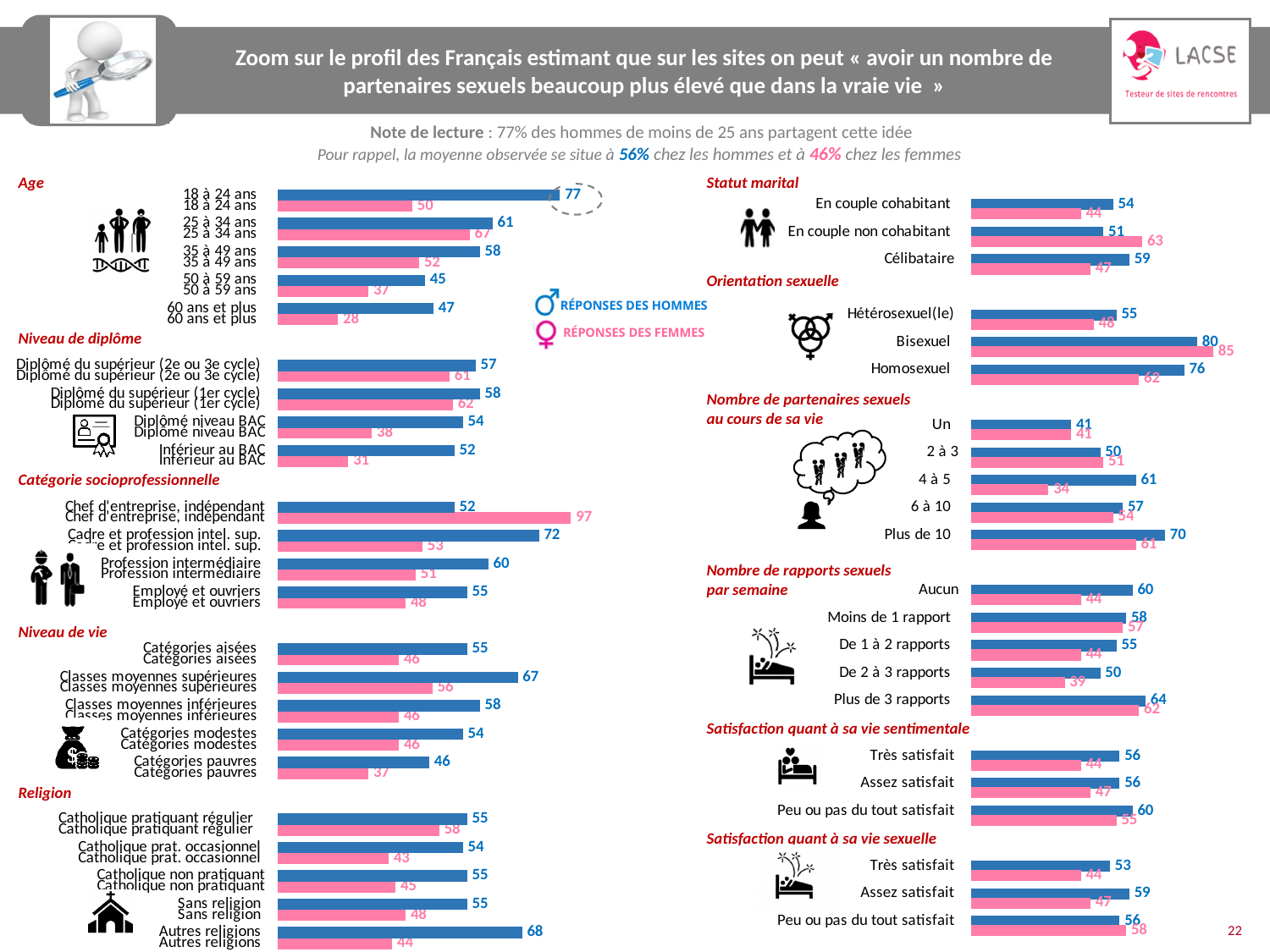
In the Age chart, what is the value for men (Réponses des hommes) aged 18 à 24 ans? 77 In the Nombre de partenaires sexuels au cours de sa vie chart, what is the men's value for Plus de 10? 70 In the Statut marital chart, which is larger for En couple non cohabitant: the men's value or the women's value? the women's value In the Niveau de diplôme chart, what is the difference between the men's and women's values for Inférieur au BAC? 21 In the Nombre de rapports sexuels par semaine chart, what is the women's value for De 2 à 3 rapports? 39 How many categories are shown in the Niveau de vie chart? 5 In the Catégorie socioprofessionnelle chart, what is the value for women (Réponses des femmes) for Chef d'entreprise, indépendant? 97 In the Orientation sexuelle chart, which category has the highest value for men? Bisexuel In the Age chart, which age group has the lowest value for women? 60 ans et plus How many series does the legend list on the slide? 2 What kind of chart is used in the Religion section? bar chart Which colour represents Réponses des femmes in the charts? pink